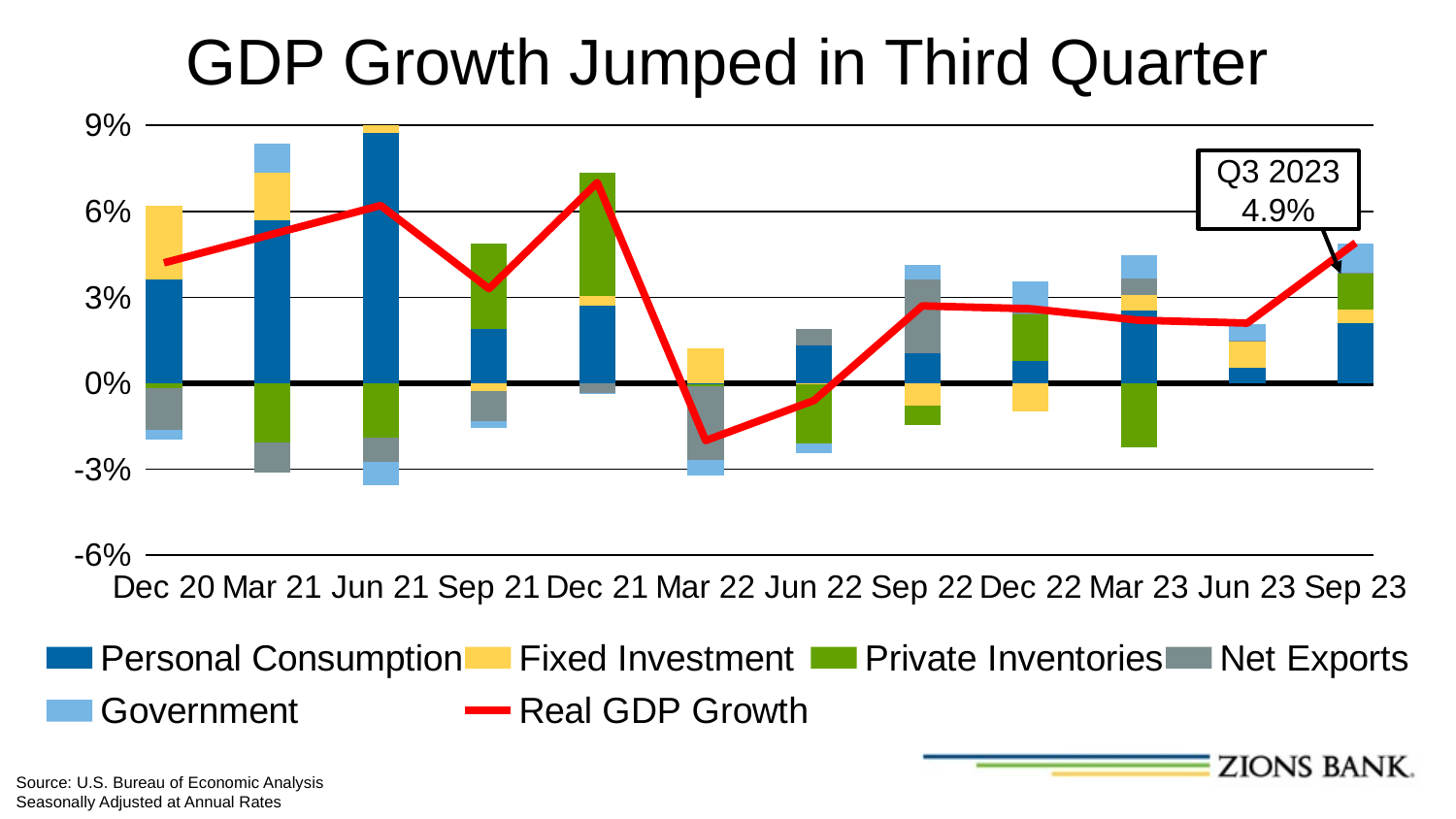
In which quarter is the Real GDP Growth line at its highest? Dec 21 In which quarter is the Real GDP Growth line at its lowest? Mar 22 How many series does the legend list? 6 Which quarter has the higher Real GDP Growth, Dec 21 or Mar 22? Dec 21 Does the Real GDP Growth line rise or fall from Jun 23 to Sep 23? Rise How many quarters are shown along the x axis? 12 What kind of chart is this? Stacked bar chart with a line Is the Real GDP Growth value for Mar 22 greater or less than 0%? less What is the Real GDP Growth value labeled for Q3 2023 (Sep 23)? 4.9% What is the title of the chart? GDP Growth Jumped in Third Quarter Is the Real GDP Growth value for Dec 21 greater or less than 6%? greater Is the Real GDP Growth value for Jun 23 greater or less than 3%? less